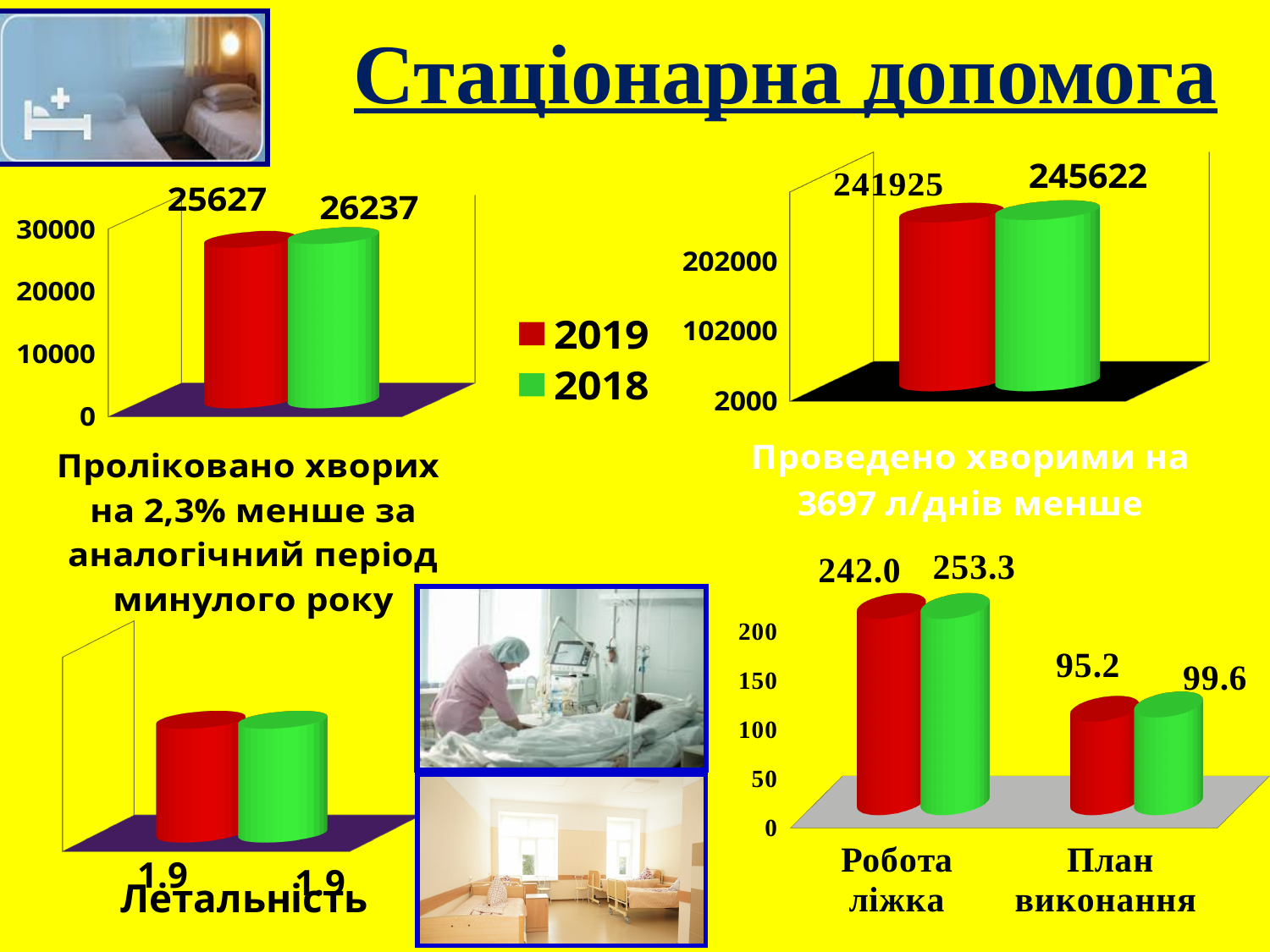
In the top-right chart, what is the value for 2018? 245622 In the bottom-right chart, what is the 2019 value for 'Робота ліжка'? 242.0 In the top-left chart, what is the value for 2018? 26237 In the bottom-right chart, what is the difference between the 2018 and 2019 values for 'Робота ліжка'? 11.3 In the bottom-left chart titled 'Летальність', what is the value for 2018? 1.9 In the top-right chart, which year has the larger value, 2019 or 2018? 2018 In the bottom-right chart, what is the 2018 value for 'План виконання'? 99.6 In the top-left chart, what is the difference between the 2018 and 2019 values? 610 How many series does the legend in the middle of the slide list? 2 In the top-left chart, what is the value for 2019? 25627 In the top-right chart, what is the value for 2019? 241925 In the bottom-right chart, is the 2019 value for 'План виконання' greater or less than 100? less